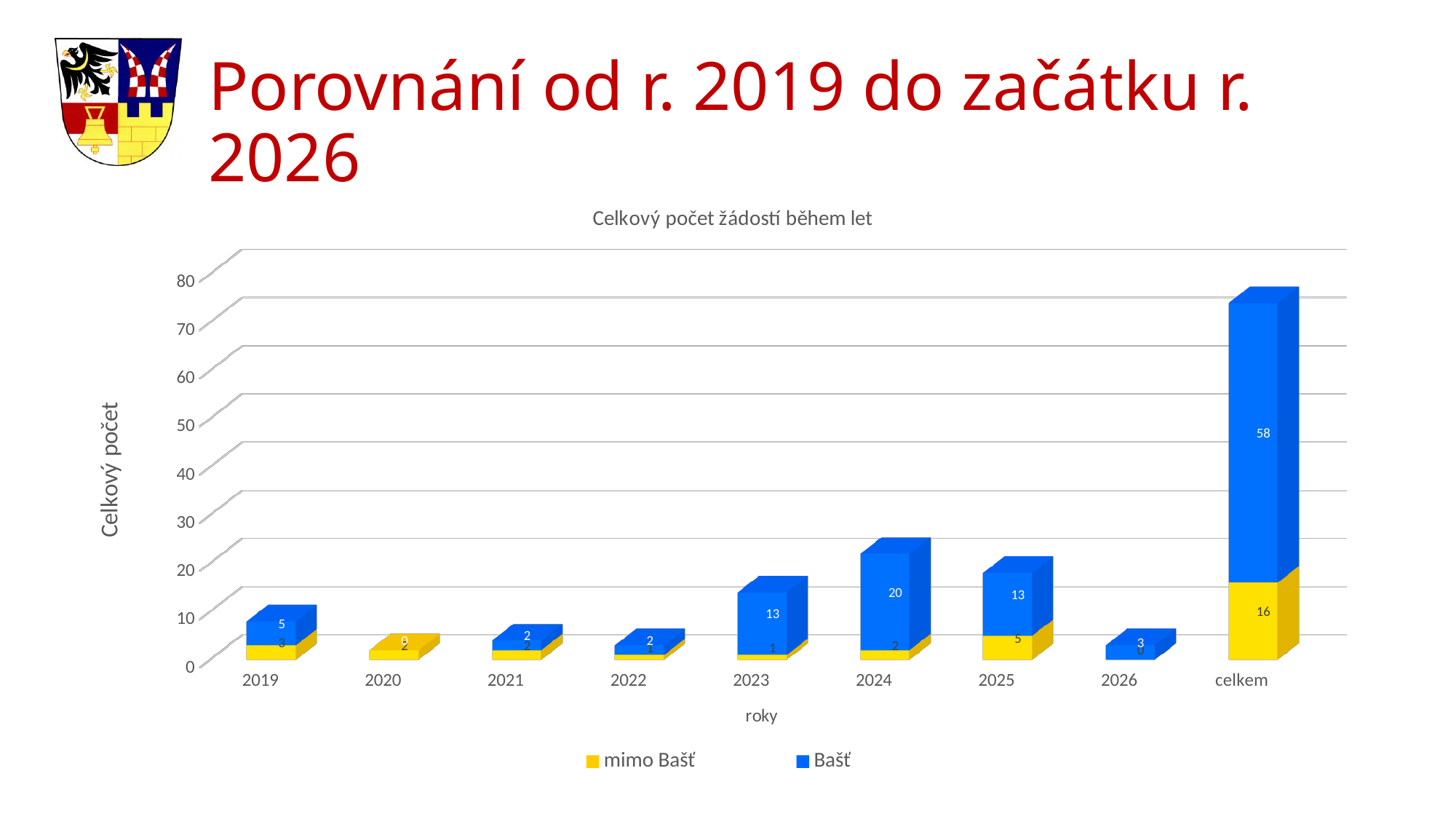
What is the value for mimo Bašť in 2019? 3 Among the year categories (excluding celkem), which year has the highest value for Bašť? 2024 How many categories are shown on the x axis? 9 What is the difference between the Bašť values for 2024 and 2025? 7 How many series does the legend list? 2 Which is larger, the Bašť value for 2023 or the Bašť value for 2019? 2023 What is the value for Bašť in the celkem category? 58 What is the value for mimo Bašť in 2025? 5 Which year has the lowest value for Bašť? 2020 What is the total of the stacked bar for celkem? 74 What kind of chart is shown on the slide? Stacked bar chart What is the value for Bašť in 2024? 20